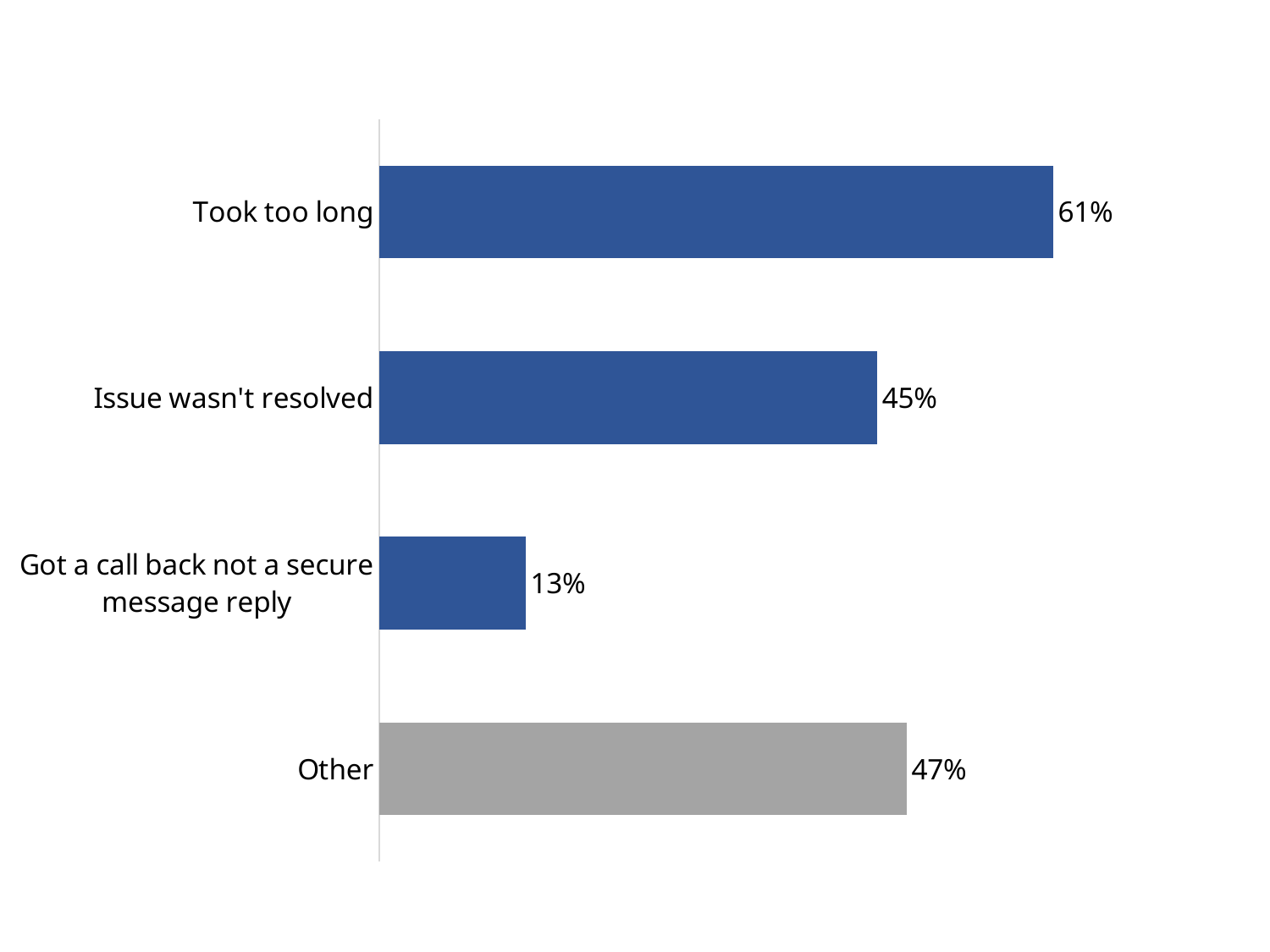
What is the difference between the values for "Other" and "Got a call back not a secure message reply"? 34% Which bar is coloured grey rather than blue? Other What is the value for "Issue wasn't resolved"? 45% How many categories are shown in the chart? 4 What is the difference between the values for "Took too long" and "Issue wasn't resolved"? 16% What kind of chart is shown on the slide? Bar chart Which is larger, the value for "Other" or the value for "Issue wasn't resolved"? Other What is the value for "Other"? 47% Which category has the highest value? Took too long Which category has the lowest value? Got a call back not a secure message reply What is the value for "Got a call back not a secure message reply"? 13% What is the value for "Took too long"? 61%